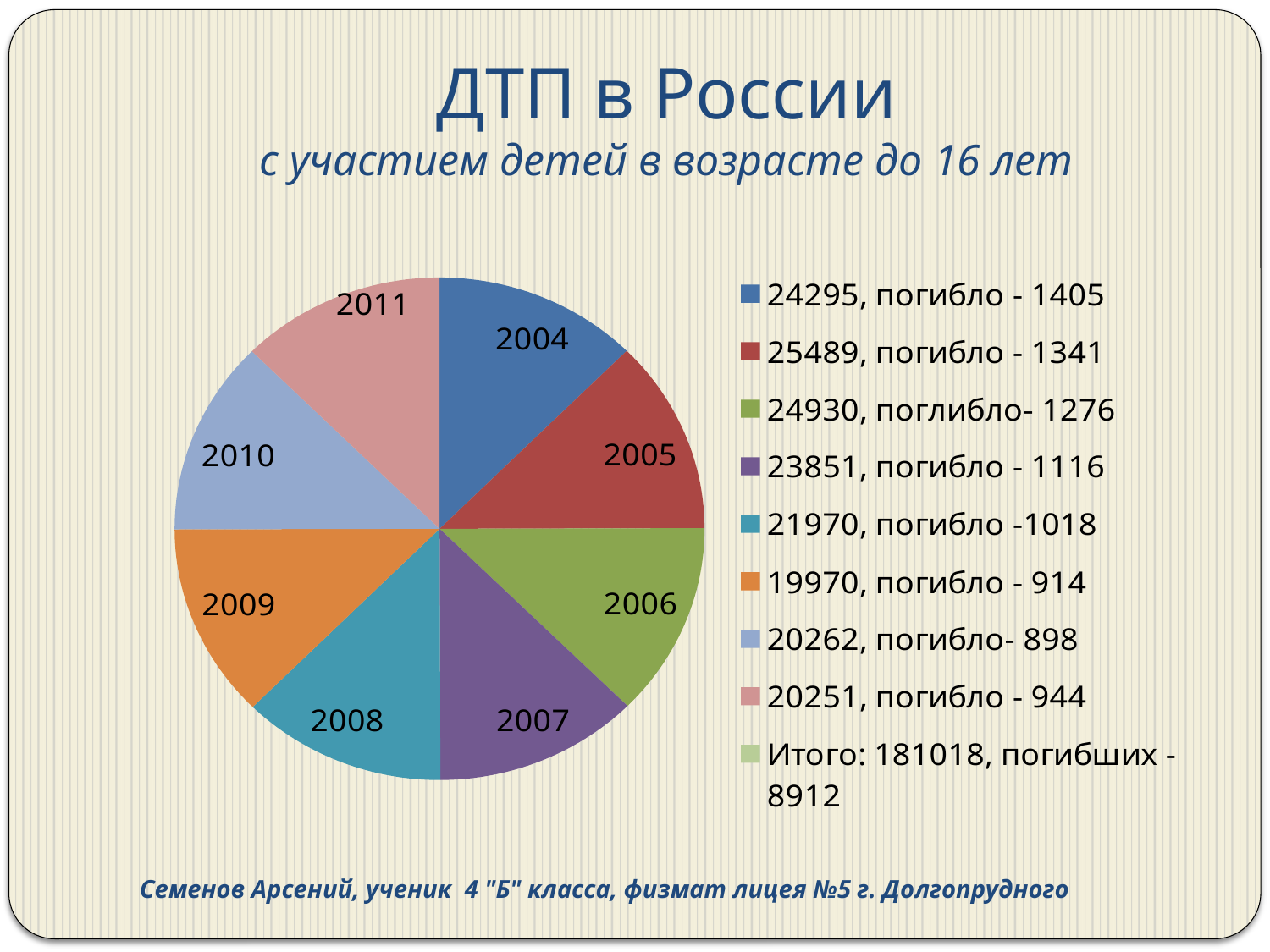
What is the number of accidents for the orange slice (2009) according to the legend? 19970 What is the difference in deaths between the blue slice (2004, 1405) and the red slice (2005, 1341)? 64 What is the main title of the slide? ДТП в России What is the number of accidents for the blue slice (2004) according to the legend? 24295 How many deaths are listed for the red slice (2005) in the legend? 1341 How many entries does the legend list? 9 According to the legend, what is the total number of accidents (Итого)? 181018 Which years are shown as slices of the pie chart? 2004 to 2011 According to the legend, what is the total number of deaths (погибших)? 8912 What kind of chart is shown on the slide? pie chart How many year slices does the pie chart have? 8 Which has more accidents according to the legend: the blue slice (2004) or the orange slice (2009)? 2004